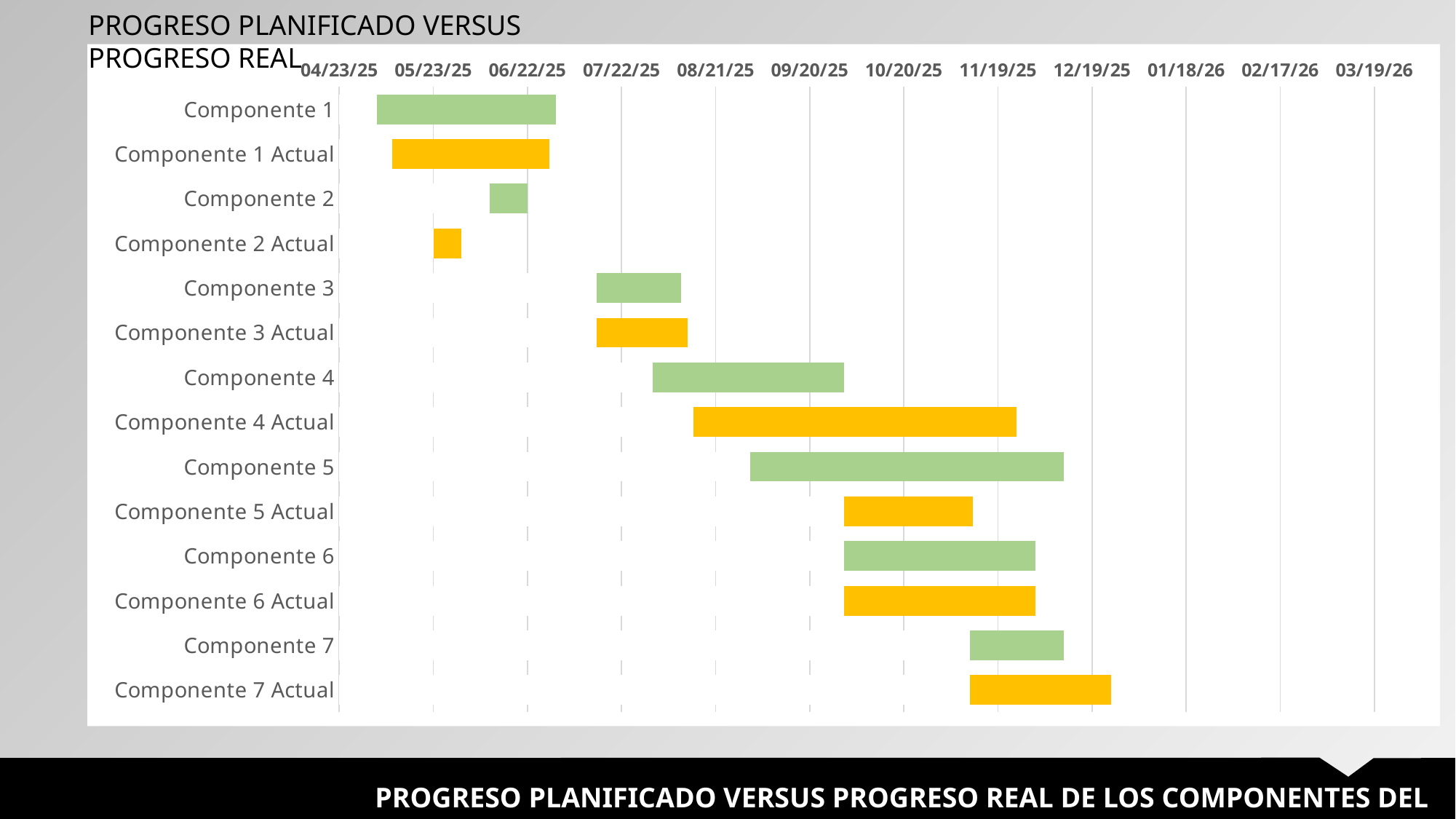
Does the Componente 7 Actual bar end before or after 12/19/25? after What kind of chart is shown on the slide? Bar chart Does the Componente 4 Actual bar end before or after 10/20/25? after Which bar is longer, Componente 7 or Componente 7 Actual? Componente 7 Actual Which bar is longer, Componente 4 or Componente 4 Actual? Componente 4 Actual How many date labels are shown along the horizontal axis of the chart? 12 How many categories (rows) are listed on the vertical axis of the chart? 14 Does the Componente 1 bar start before or after 05/23/25? before What is the title of the chart? PROGRESO PLANIFICADO VERSUS PROGRESO REAL Which bar is longer, Componente 5 or Componente 5 Actual? Componente 5 What colour are the bars for the 'Actual' rows in the chart? Yellow Which row has the shortest bar in the chart? Componente 2 Actual